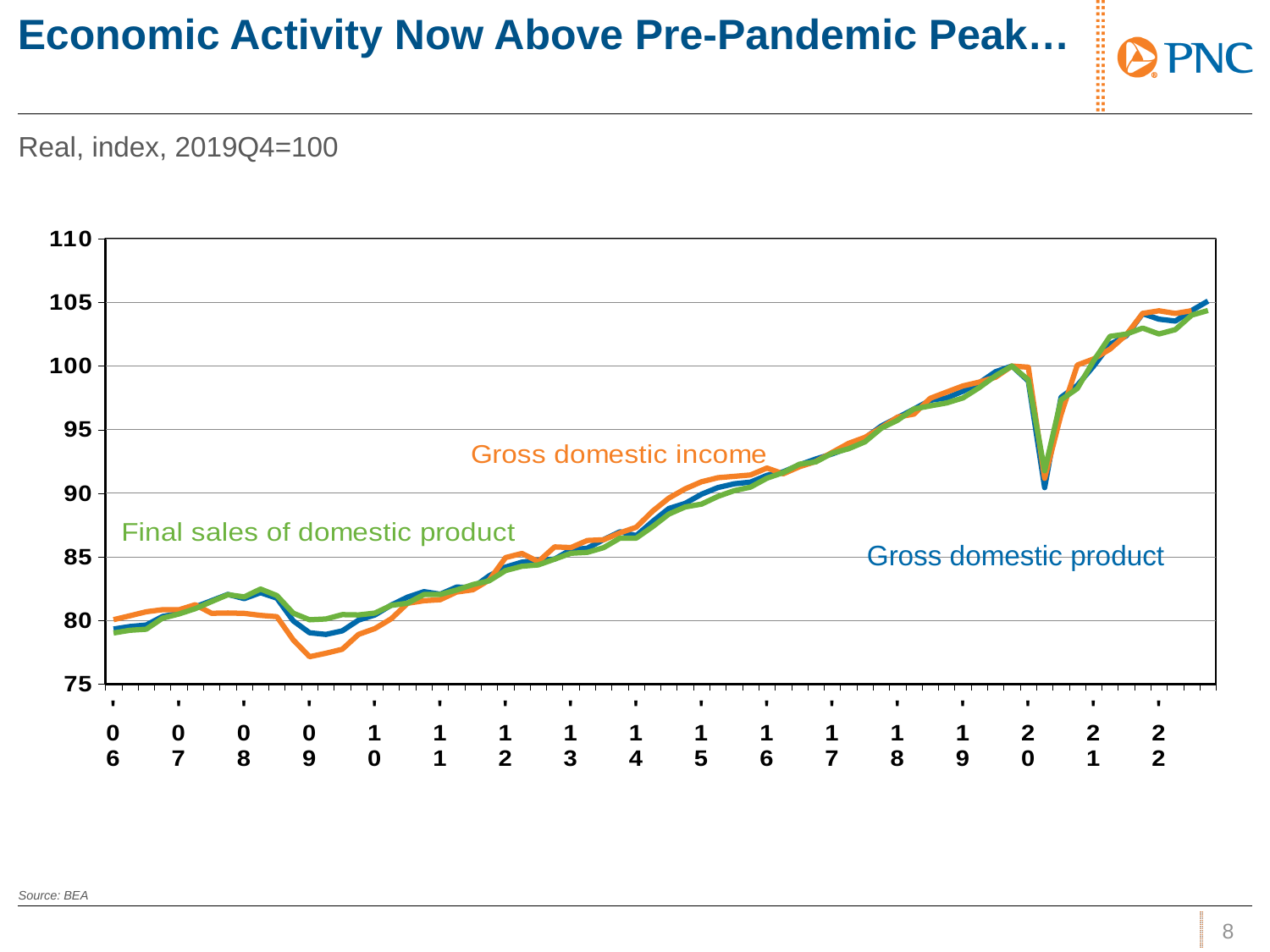
Is the value of Final sales of domestic product in 18 greater or less than 95? greater How many series are plotted on the chart? 3 Is the lowest value of Gross domestic product in 20 greater or less than 95? less Which series dips lowest in 09? Gross domestic income What kind of chart is shown on the slide? line chart What is the title of the slide? Economic Activity Now Above Pre-Pandemic Peak… Is the value of Gross domestic product at the end of 22 greater or less than 100? greater Which series is drawn in orange? Gross domestic income How many year labels are shown on the x axis? 17 Overall, do the series rise or fall from 06 to 22? rise